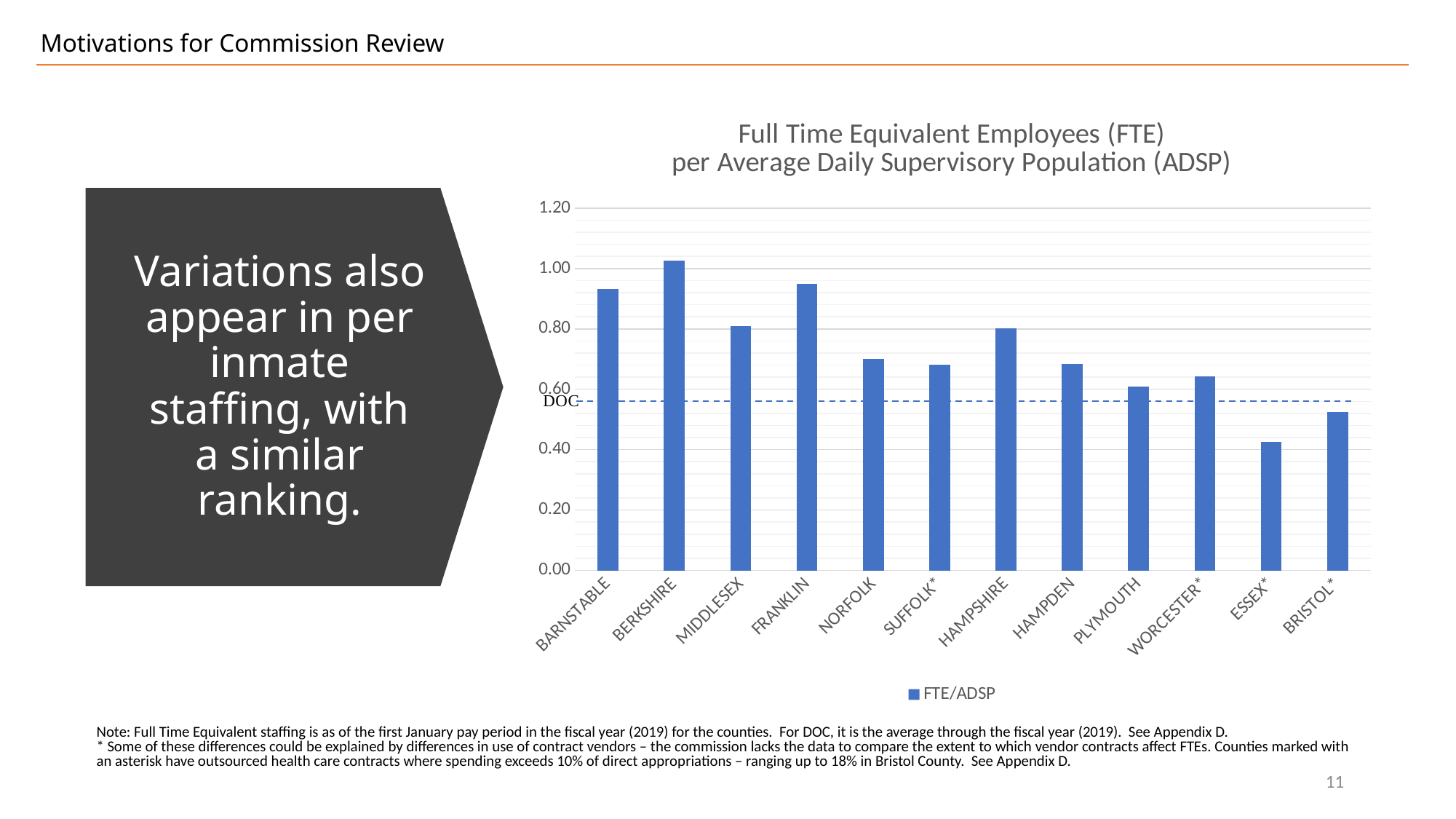
What kind of chart is shown on the slide? bar chart How many series does the legend list? 1 Which county has the lowest FTE/ADSP value? ESSEX* What label is given to the dashed horizontal reference line on the chart? DOC Is the FTE/ADSP value for BRISTOL* greater or less than 0.60? less Is the FTE/ADSP value for BERKSHIRE greater or less than 1.00? greater Which has a higher FTE/ADSP value, FRANKLIN or NORFOLK? FRANKLIN Which has a higher FTE/ADSP value, BARNSTABLE or ESSEX*? BARNSTABLE Is the FTE/ADSP value for ESSEX* greater or less than 0.60? less Which county has the highest FTE/ADSP value? BERKSHIRE How many counties are shown on the x axis of the chart? 12